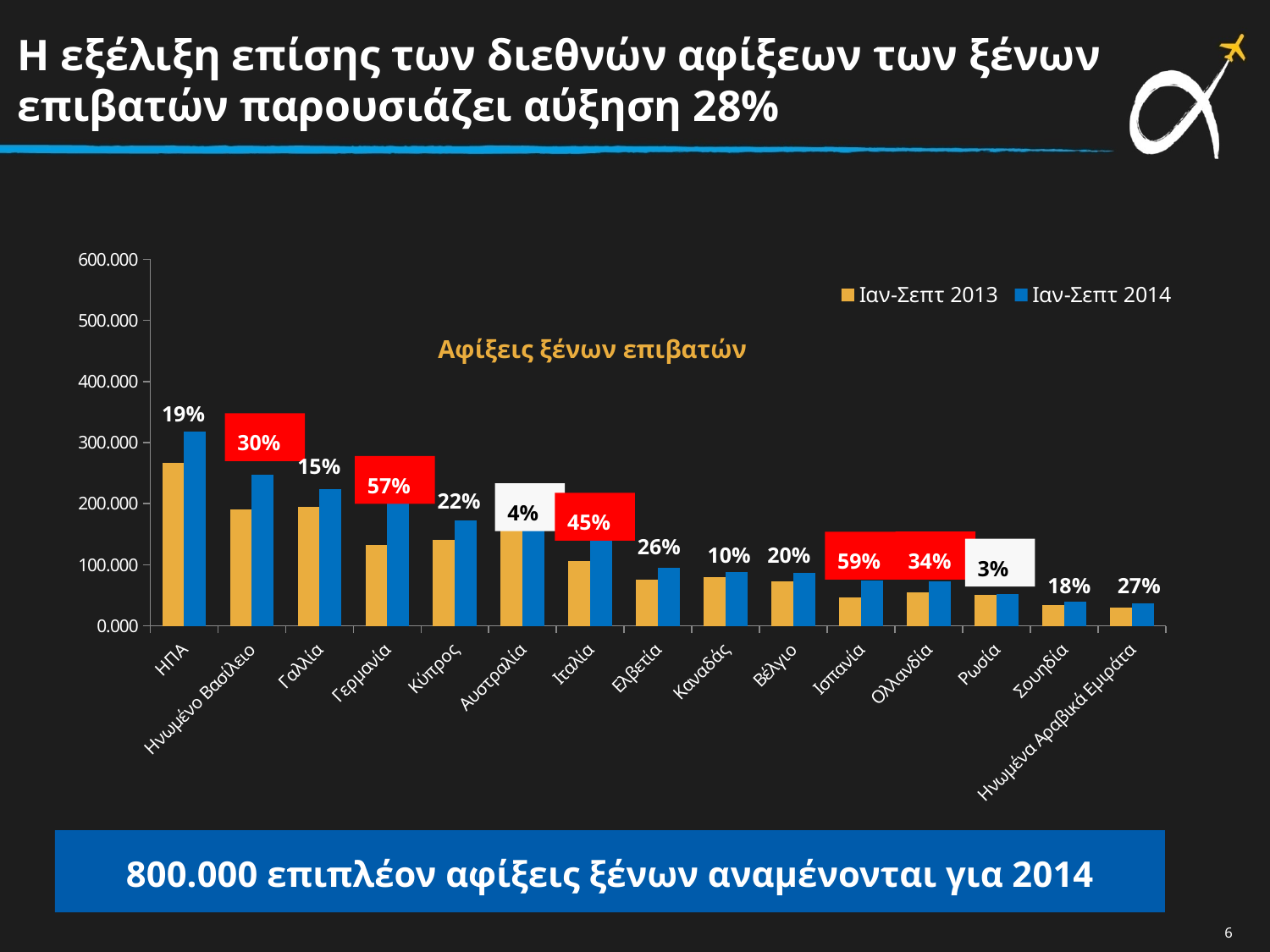
What type of chart is shown on the slide? Bar chart Is the Ιαν-Σεπτ 2014 value for ΗΠΑ greater or less than 300.000? greater Which country has the tallest bar for Ιαν-Σεπτ 2014? ΗΠΑ What percentage change is shown above the bars for Γερμανία? 57% Which country has the highest percentage change label on the chart? Ισπανία Which country has the lowest percentage change label on the chart? Ρωσία How many countries are shown on the x axis of the chart? 15 What percentage change is shown for Ηνωμένα Αραβικά Εμιράτα? 27% Which is larger: the Ιαν-Σεπτ 2014 value for Ηνωμένο Βασίλειο or for Κύπρος? Ηνωμένο Βασίλειο What percentage change is shown for Ρωσία? 3% Is the Ιαν-Σεπτ 2013 value for Γερμανία greater or less than 200.000? less How many series does the legend list? 2